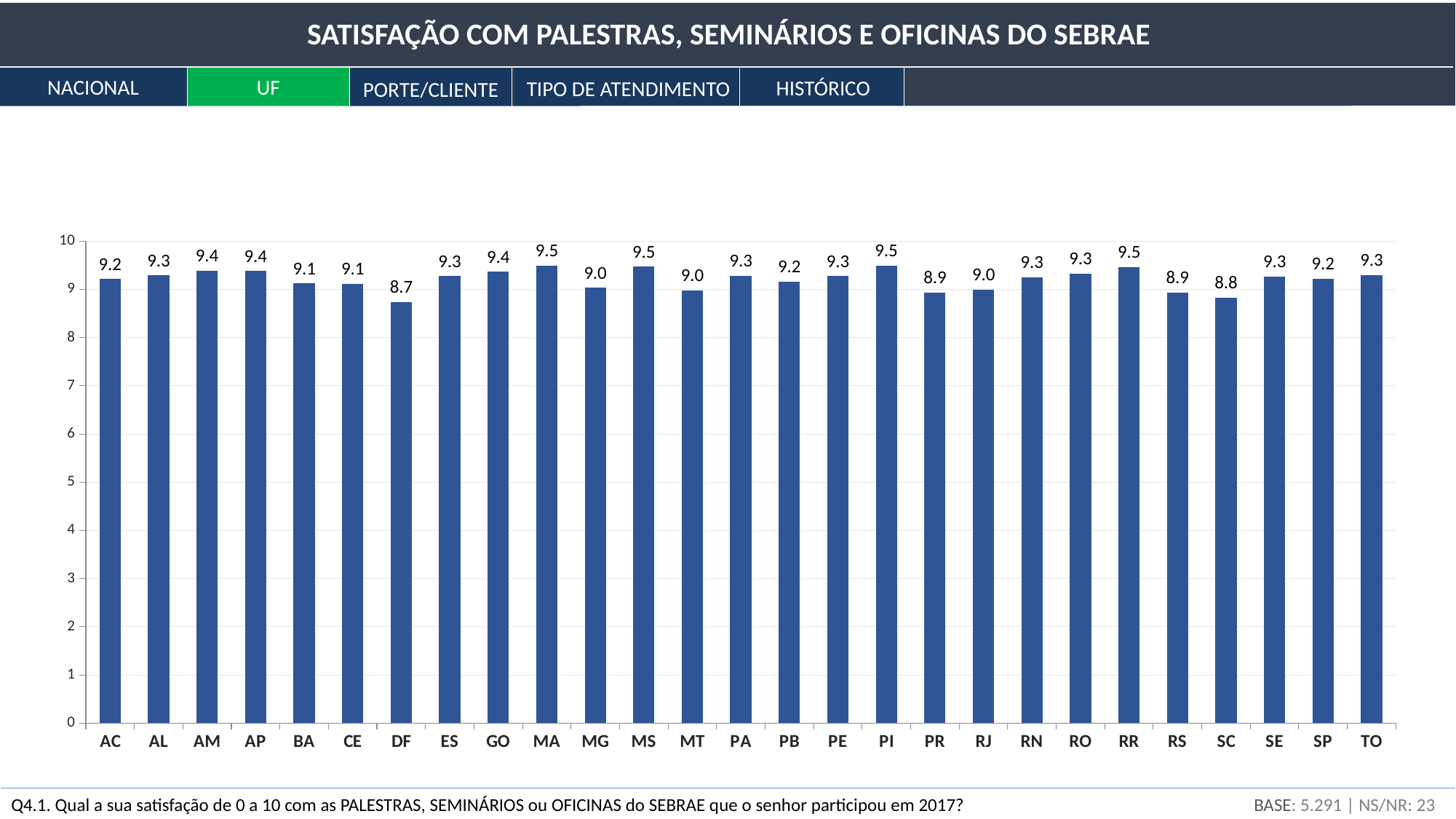
What is the value for SC? 8.8 Which state (UF) has the lowest value? DF Which has a larger value, AM or DF? AM What is the value for SP? 9.2 Is the value for DF greater or less than 9? less How many states (UF) are shown on the x axis? 27 What is the value for MA? 9.5 What is the difference between the values for AM and SC? 0.6 What kind of chart is shown on the slide? bar chart What is the difference between the values for MA and DF? 0.8 What is the value for DF? 8.7 Which has a larger value, RS or PI? PI